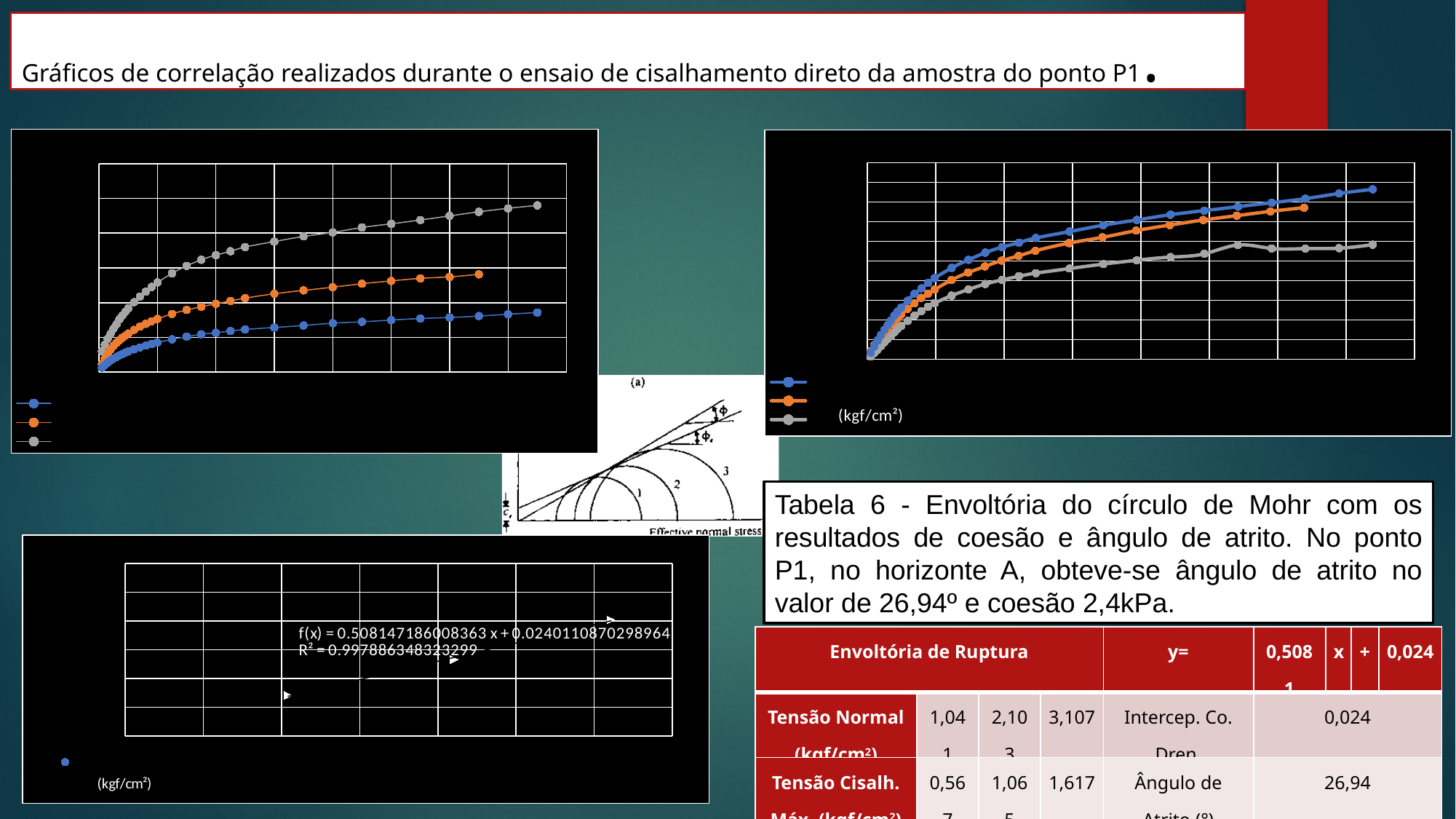
In the top-left chart, which series (by colour) has the lowest values? blue In the top-left chart, do the values of the series rise or fall along the x axis? rise In the top-right chart, which series (by colour) has the lowest values at the right end? gray What kind of chart is the top-left chart? line chart What R² value is shown on the bottom-left chart? R² = 0.997886348323299 What is the trendline equation shown on the bottom-left chart? f(x) = 0.508147186008363 x + 0.0240110870298964 How many series does the legend of the top-right chart list? 3 What unit is shown on the x axis of the bottom-left chart? (kgf/cm²) In the top-left chart, which series (by colour) has the highest values? gray In the top-right chart, which series (by colour) has the highest values at the right end? blue In the top-right chart, do the values rise or fall along the x axis? rise How many series does the legend of the top-left chart list? 3